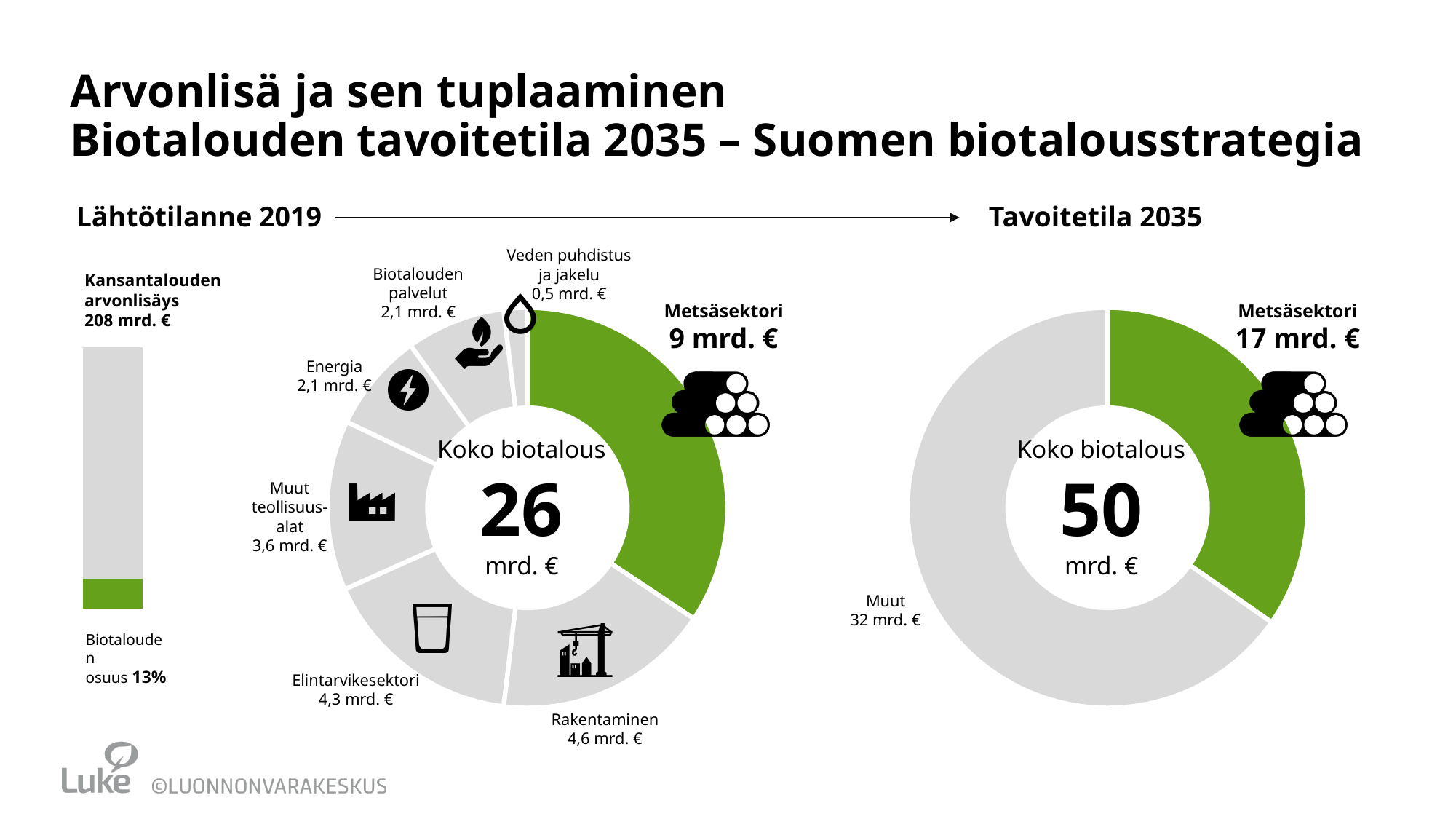
In the Lähtötilanne 2019 donut chart, which is larger: Elintarvikesektori or Muut teollisuusalat? Elintarvikesektori In the Tavoitetila 2035 donut chart, what is the value for Muut? 32 mrd. € In the Lähtötilanne 2019 donut chart, which sector has the highest value? Metsäsektori In the Lähtötilanne 2019 donut chart, what is the value for Metsäsektori? 9 mrd. € In the Lähtötilanne 2019 donut chart, which sector has the lowest value? Veden puhdistus ja jakelu In the Lähtötilanne 2019 donut chart, what is the value for Veden puhdistus ja jakelu? 0,5 mrd. € How many sectors are shown in the Lähtötilanne 2019 donut chart? 7 What type of chart is used for Tavoitetila 2035? Donut chart In the Tavoitetila 2035 donut chart, what share of the total does Metsäsektori represent? 34% In the Lähtötilanne 2019 donut chart, what is the value for Rakentaminen? 4,6 mrd. € What is the difference between the Metsäsektori value in the Tavoitetila 2035 chart and the Metsäsektori value in the Lähtötilanne 2019 chart? 8 mrd. € What is the total value shown in the centre of the Tavoitetila 2035 donut chart? 50 mrd. €